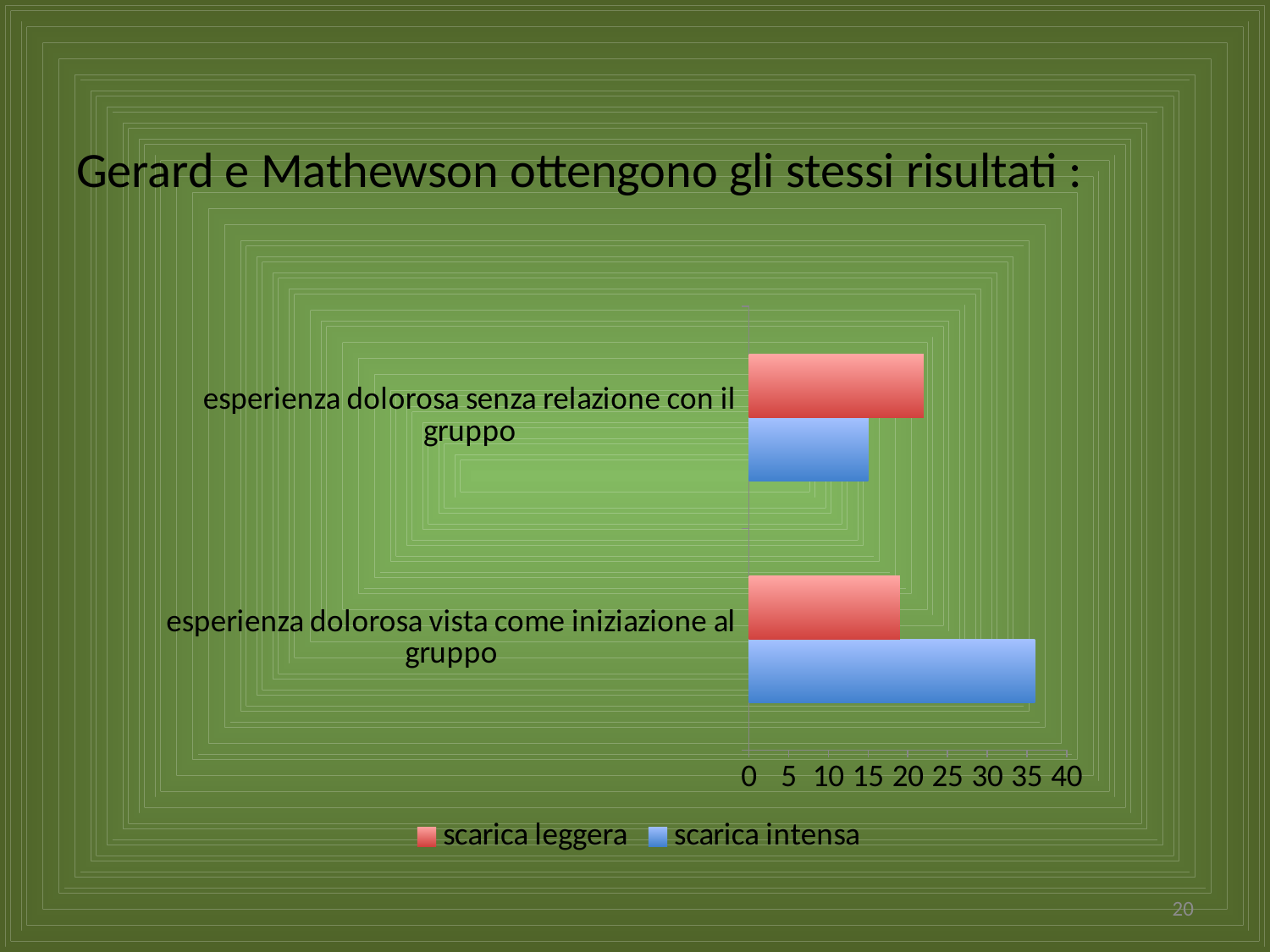
Is the value of scarica leggera for 'esperienza dolorosa vista come iniziazione al gruppo' greater or less than 25? less What are the two series named in the legend? scarica leggera, scarica intensa For 'esperienza dolorosa vista come iniziazione al gruppo', which series has the larger value, scarica leggera or scarica intensa? scarica intensa Is the value of scarica intensa for 'esperienza dolorosa vista come iniziazione al gruppo' greater or less than 30? greater What kind of chart is shown on the slide? bar chart How many categories are shown on the chart? 2 Is the value of scarica intensa for 'esperienza dolorosa senza relazione con il gruppo' greater or less than 20? less Which category has the highest value for scarica intensa? esperienza dolorosa vista come iniziazione al gruppo What is the title of the slide above the chart? Gerard e Mathewson ottengono gli stessi risultati : How many series does the legend list? 2 For 'esperienza dolorosa senza relazione con il gruppo', which series has the larger value, scarica leggera or scarica intensa? scarica leggera